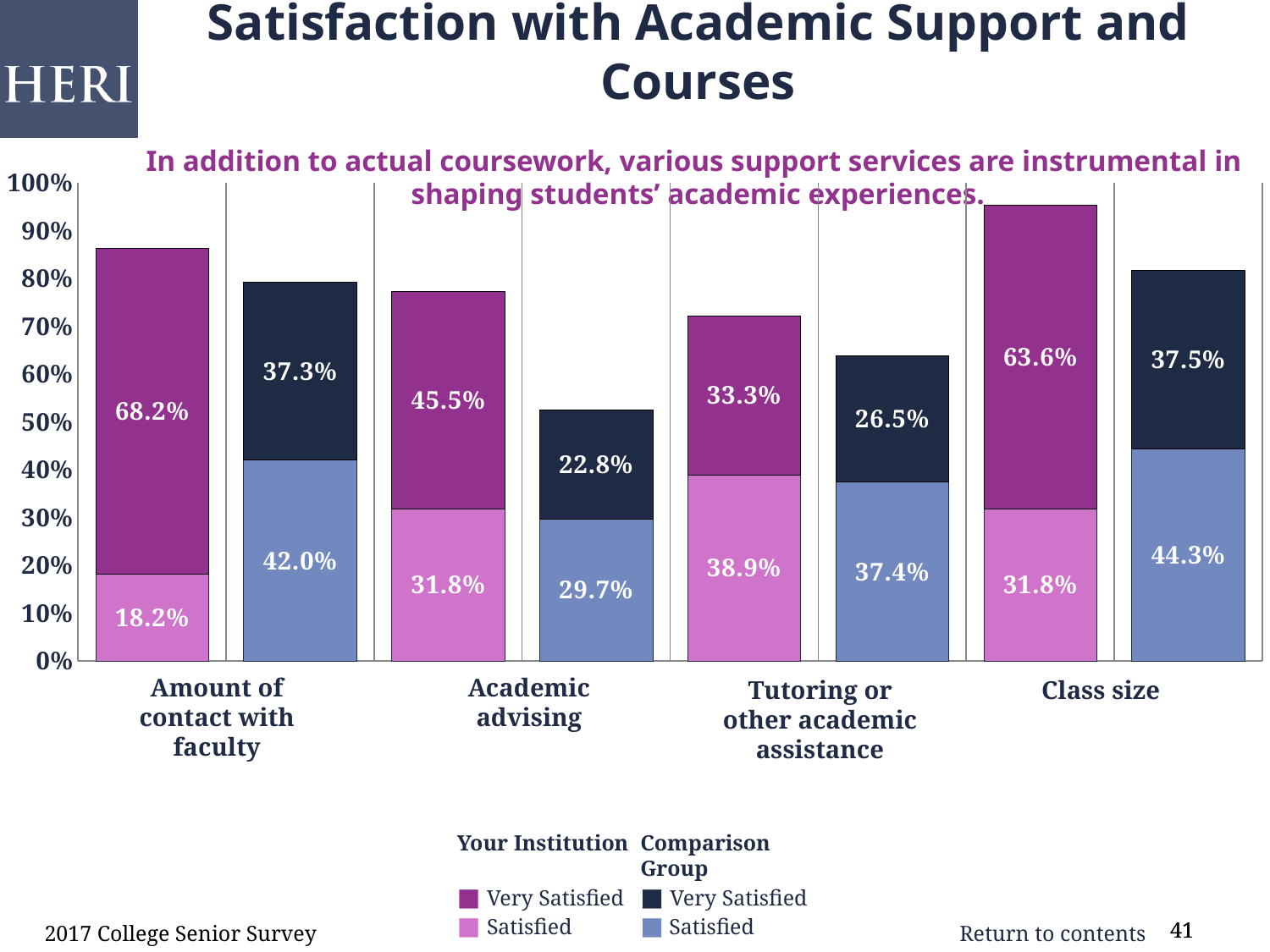
What percentage of the Comparison Group was Very Satisfied with academic advising? 22.8% What is the total (Satisfied plus Very Satisfied) for Your Institution's class size bar? 95.4% What kind of chart is shown on the slide? Stacked bar chart Which is larger: the Satisfied percentage for Your Institution or for the Comparison Group for tutoring or other academic assistance? Your Institution Which category has the lowest Very Satisfied percentage for the Comparison Group? Academic advising How many categories are shown on the x axis? 4 What percentage of Your Institution students were Very Satisfied with the amount of contact with faculty? 68.2% What is the total (Satisfied plus Very Satisfied) for the Comparison Group's academic advising bar? 52.5% What percentage of the Comparison Group was Satisfied with class size? 44.3% How many series does the legend list? 4 Across the four categories, which has the highest Very Satisfied percentage for Your Institution? Amount of contact with faculty What is the difference between the Very Satisfied percentages for Your Institution and the Comparison Group for class size? 26.1%